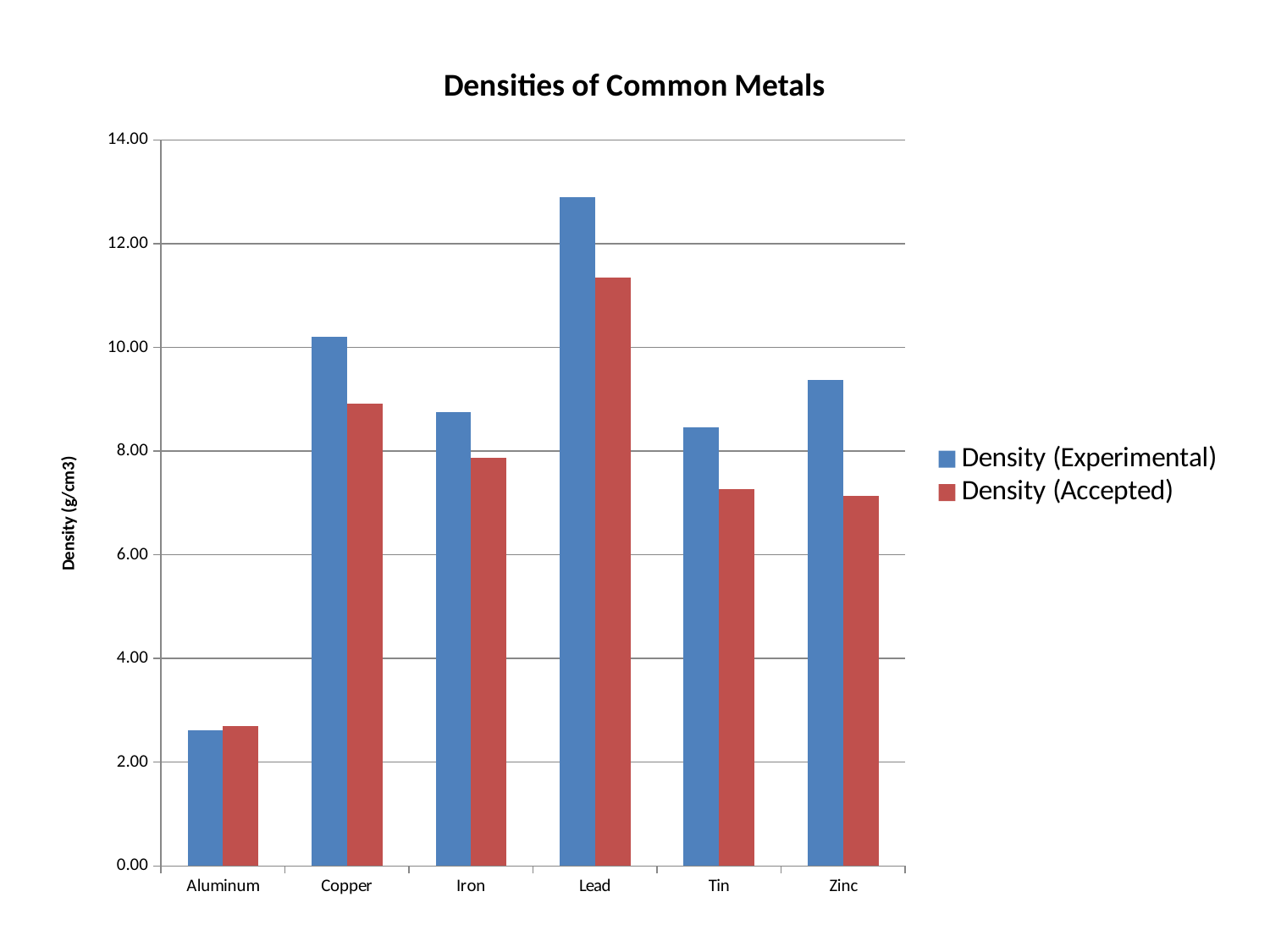
Is the Density (Accepted) value for Tin greater or less than 8.00? less How many series does the legend list? 2 What kind of chart is shown on the slide? bar chart Which is larger: the Density (Experimental) for Zinc or the Density (Experimental) for Tin? Zinc Is the Density (Experimental) value for Copper greater or less than 10.00? greater Which metal has the lowest Density (Accepted)? Aluminum Which metal has the highest Density (Experimental)? Lead How many metals are shown on the x axis? 6 Is the Density (Experimental) value for Lead greater or less than 12.00? greater Which is larger: the Density (Accepted) for Lead or the Density (Experimental) for Copper? Density (Accepted) for Lead What is the title of the chart? Densities of Common Metals